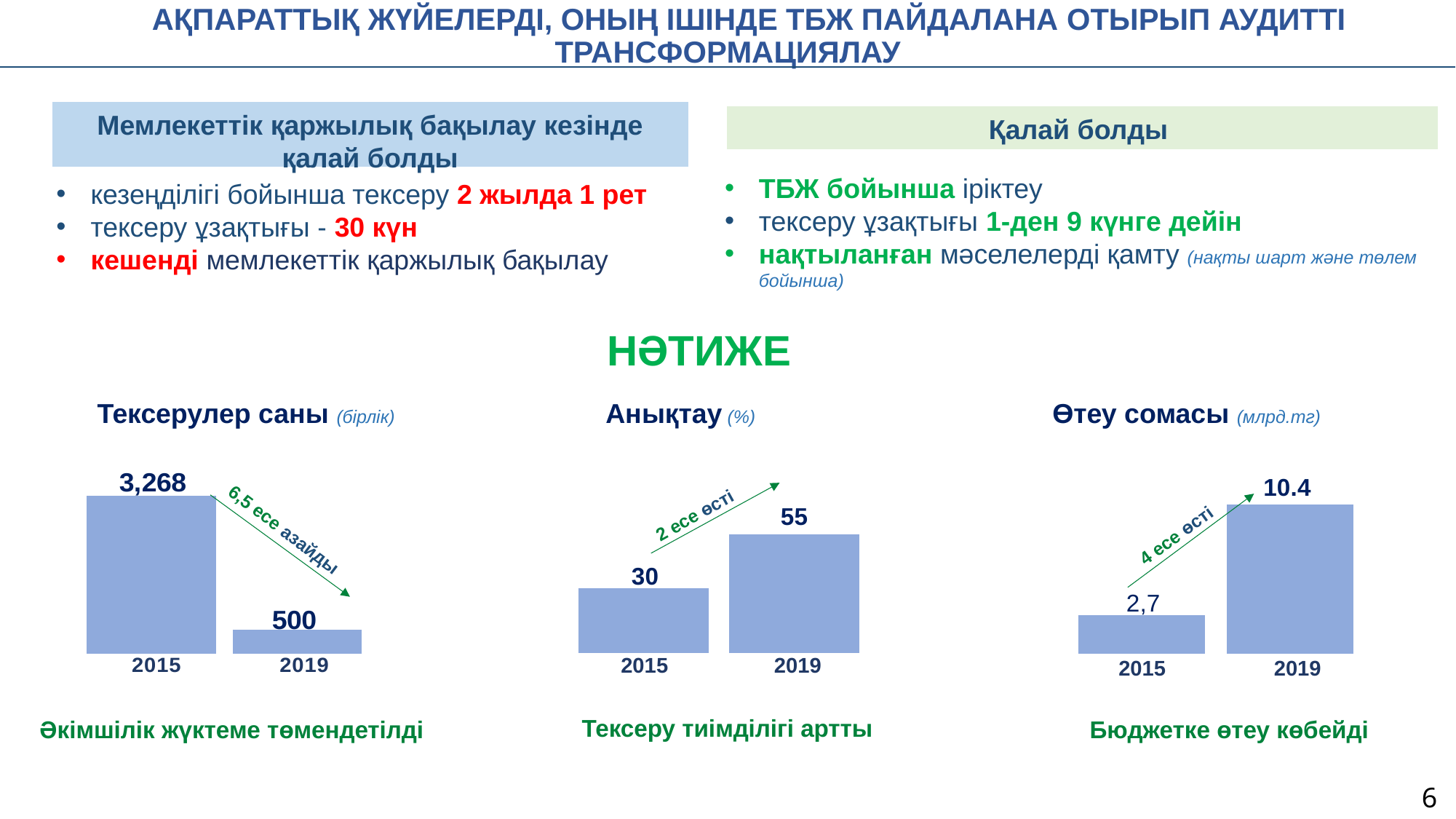
In the 'Тексерулер саны' chart, what is the value for 2019? 500 In the 'Өтеу сомасы' chart, is the value for 2015 or 2019 larger? 2019 In the 'Тексерулер саны' chart, what is the value for 2015? 3,268 In the 'Өтеу сомасы' chart, what is the value for 2019? 10.4 In the 'Анықтау' chart, what is the value for 2019? 55 In the 'Өтеу сомасы' chart, what is the value for 2015? 2,7 What kind of chart is the 'Өтеу сомасы' chart? bar chart In the 'Анықтау' chart, what is the value for 2015? 30 In the 'Тексерулер саны' chart, do the values rise or fall from 2015 to 2019? fall In the 'Тексерулер саны' chart, which year has the lower value? 2019 In the 'Анықтау' chart, what is the difference between the 2019 and 2015 values? 25 In the 'Анықтау' chart, which year has the higher value? 2019